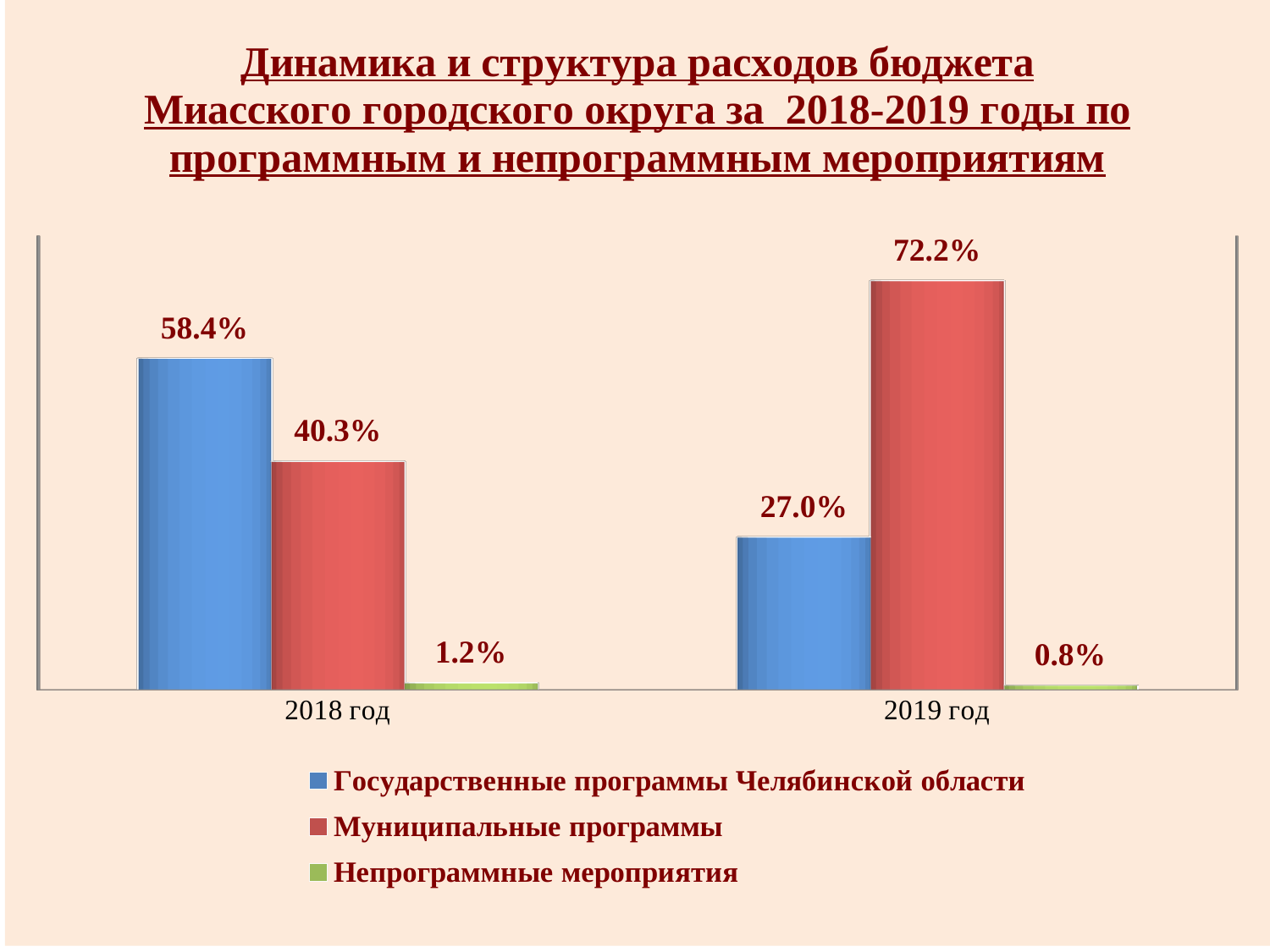
Which is larger: Государственные программы Челябинской области in 2018 год or Муниципальные программы in 2018 год? Государственные программы Челябинской области in 2018 год How many year categories are shown on the x axis? 2 What is the value for Непрограммные мероприятия in 2018 год? 1.2% What is the value for Муниципальные программы in 2019 год? 72.2% What is the value for Государственные программы Челябинской области in 2018 год? 58.4% What kind of chart is shown on the slide? Bar chart Which series has the highest value in 2019 год? Муниципальные программы Which series has the lowest value in 2018 год? Непрограммные мероприятия How many series does the legend list? 3 What is the difference between the Муниципальные программы values for 2019 год and 2018 год? 31.9% Does the value for Государственные программы Челябинской области rise or fall from 2018 год to 2019 год? Fall What is the value for Государственные программы Челябинской области in 2019 год? 27.0%